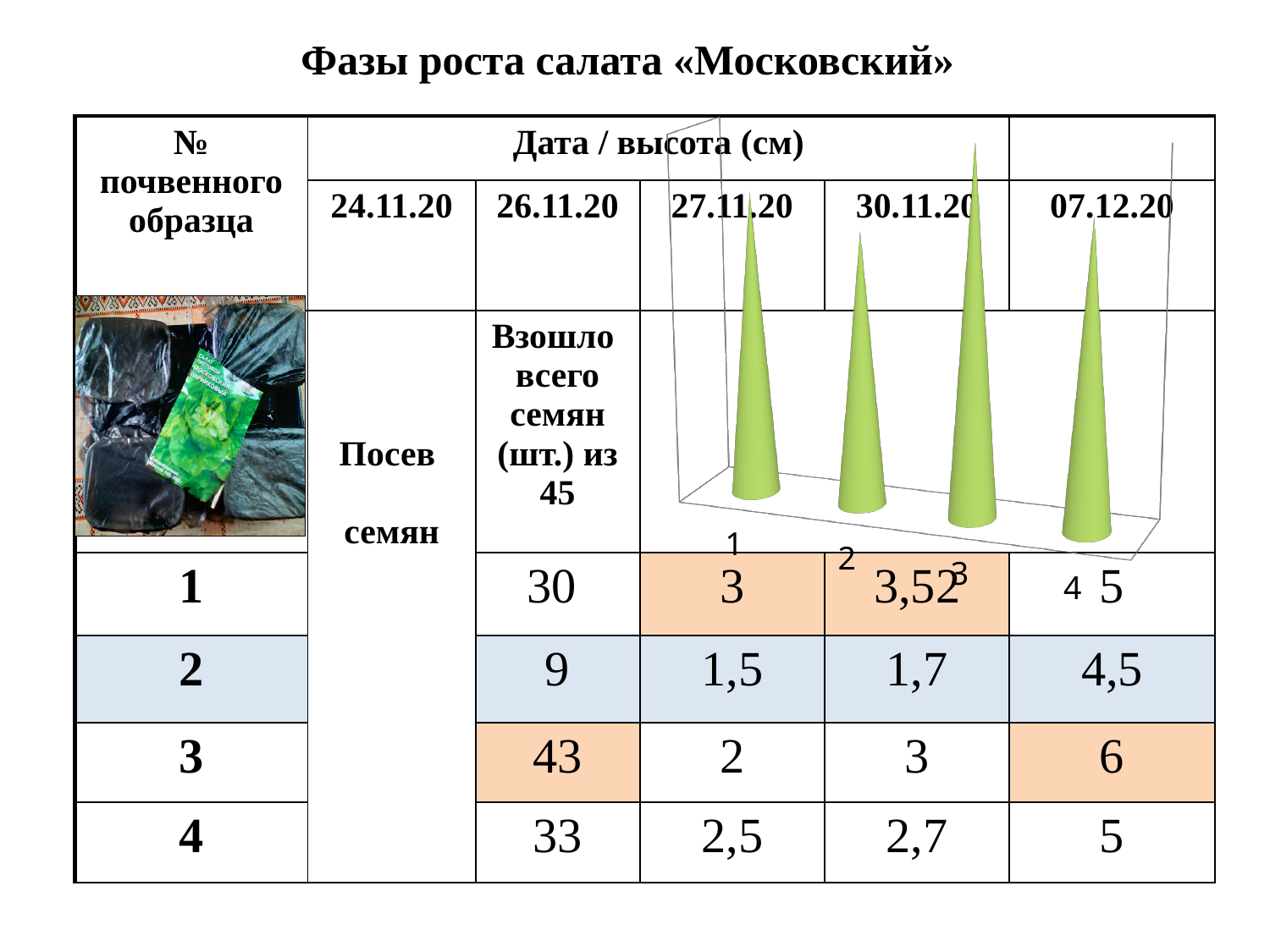
Which category has the tallest cone in the chart? 3 In the chart, is the cone for category 3 taller or shorter than the cone for category 2? taller What kind of chart is shown on the slide? 3D bar chart (cone-shaped bars) Which category has the shortest cone in the chart? 2 How many categories (cones) are plotted in the chart? 4 In the chart, which is taller: the cone for category 3 or the cone for category 4? 3 What colour are the cones in the chart? green What are the category labels shown along the base of the chart? 1, 2, 3, 4 In the chart, which is taller: the cone for category 1 or the cone for category 2? 1